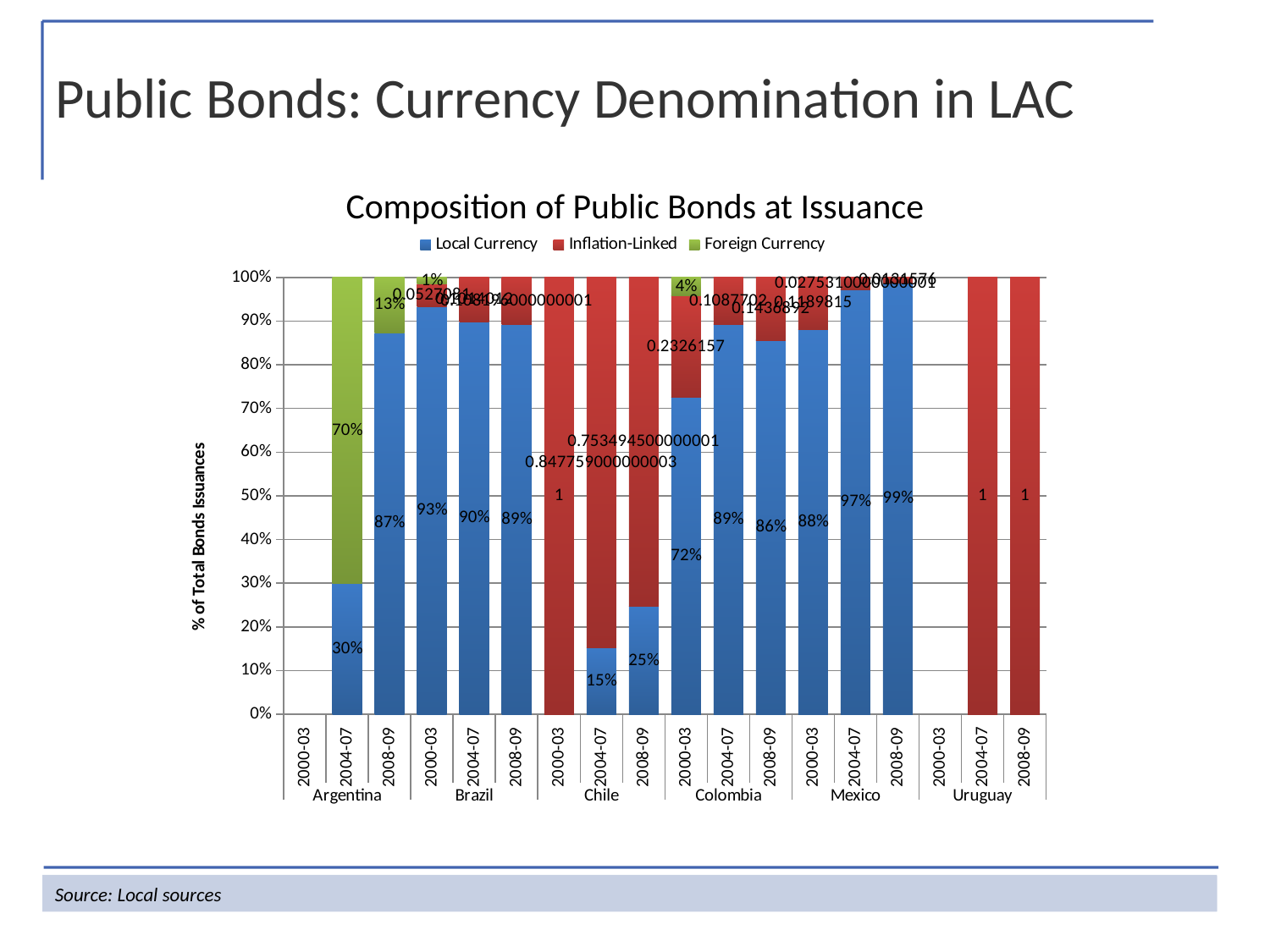
What is the difference between Brazil's Local Currency share in 2000-03 and in 2008-09? 4 percentage points Which is larger: the Local Currency share for Argentina in 2004-07 or for Chile in 2008-09? Argentina 2004-07 What kind of chart is shown on the slide? Stacked bar chart What is the Local Currency share for Chile in 2004-07? 15% What is the Inflation-Linked value labelled for Colombia in 2000-03? 0.2326157 Which series is shown in green in the legend? Foreign Currency Does the Local Currency share for Mexico rise or fall from 2000-03 to 2008-09? Rise How many countries are shown along the x axis? 6 What is the Local Currency share for Argentina in 2004-07? 30% Which country and period has the highest Local Currency share? Mexico, 2008-09 (99%) How many series does the legend list? 3 What is the Foreign Currency share for Argentina in 2004-07? 70%